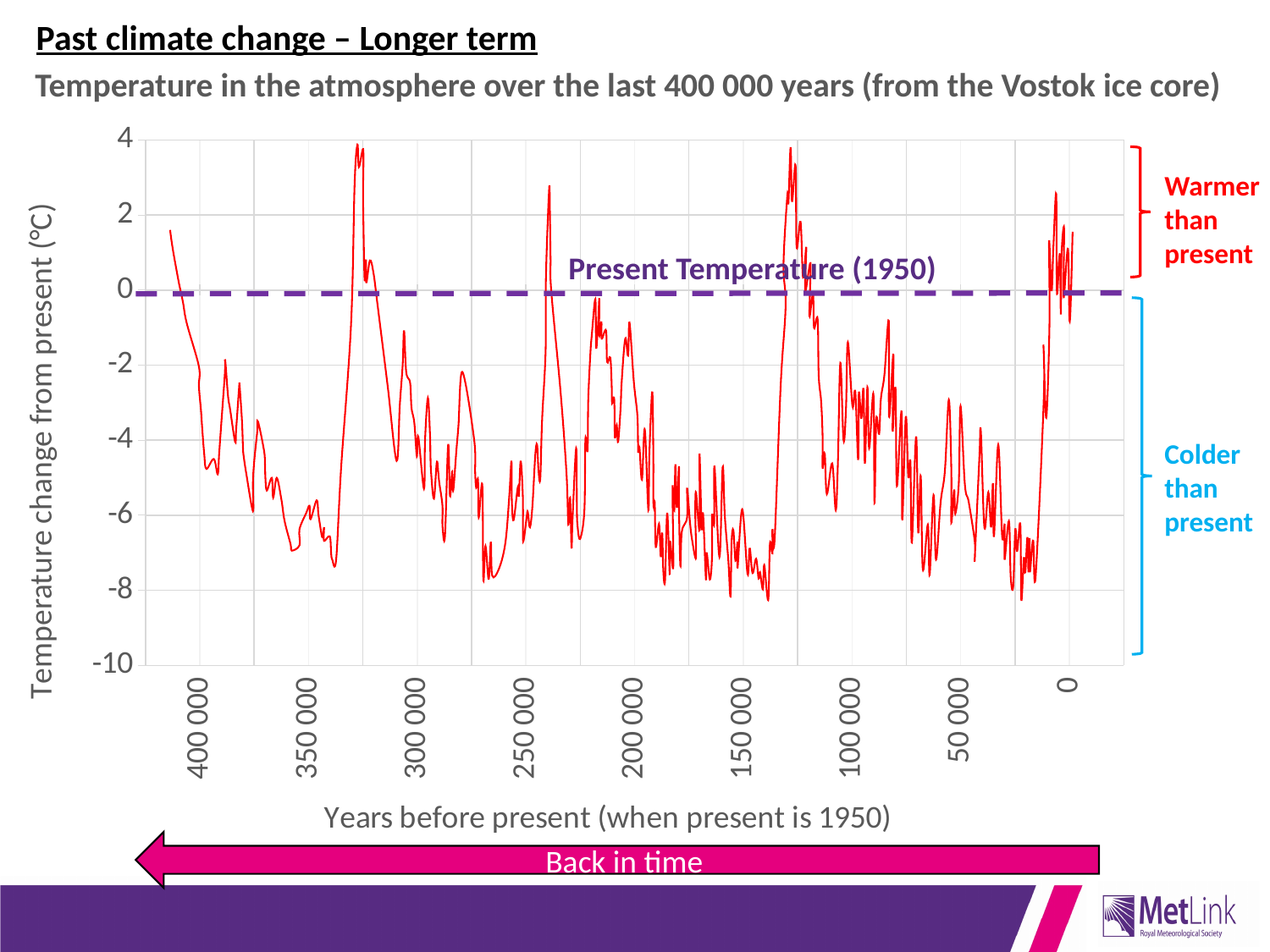
How many data series (lines) are plotted on the chart? 1 Is the temperature change at 350 000 years before present greater or less than -4? less What is the label of the vertical axis? Temperature change from present (°C) Is the temperature change at 50 000 years before present greater or less than -4? less What is the title of the chart? Temperature in the atmosphere over the last 400 000 years (from the Vostok ice core) Is the peak temperature change near 130 000 years before present greater or less than 2? greater What is the lowest value shown on the vertical axis? -10 What kind of chart is shown on the slide? line chart What value on the vertical axis does the dashed 'Present Temperature (1950)' line sit at? 0